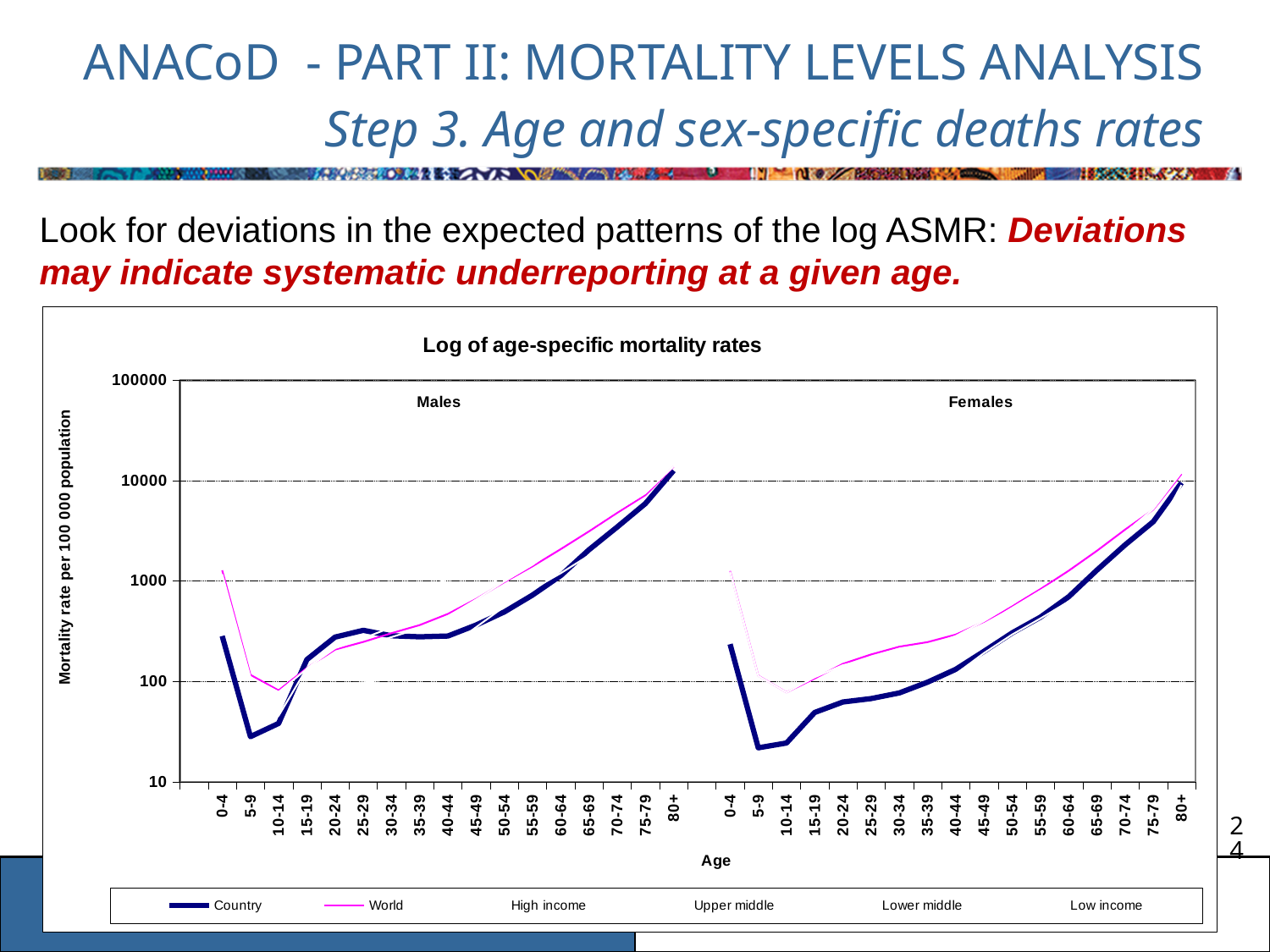
What is the title of the chart? Log of age-specific mortality rates In the Males panel, is the Country value for age 5-9 greater or less than 100? less In the Females panel, is the Country value for age 5-9 greater or less than 100? less In the Males panel, is the Country value for age 25-29 greater or less than 100? greater What kind of chart is shown on the slide? line chart How many age groups are plotted on the x axis for the Males panel? 17 In the Males panel, which age group has the highest Country mortality rate? 80+ What is the label of the y axis? Mortality rate per 100 000 population In the Males panel, which age group has the lowest Country mortality rate? 5-9 How many series does the chart legend list? 6 In the Males panel at age 5-9, which series is higher, Country or World? World